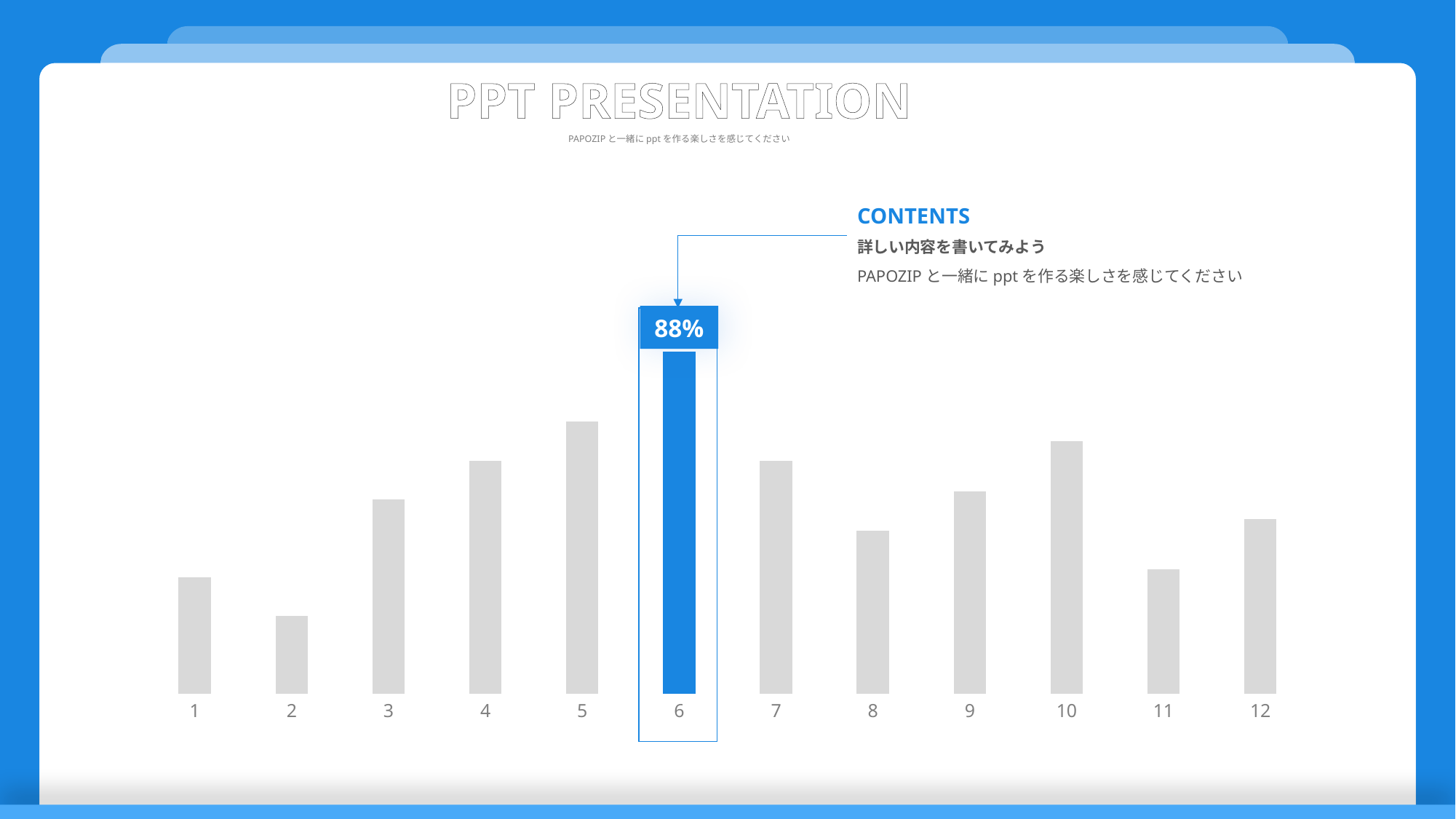
What colour is the highlighted bar for category 6? blue Which bar is taller, category 3 or category 4? 4 Which category has the tallest bar? 6 Which bar is taller, category 1 or category 2? 1 Which category's bar is highlighted with a data label and callout box? 6 Do the bar values rise or fall from category 6 to category 8? fall How many categories are shown on the x axis? 12 Which bar is taller, category 5 or category 7? 5 What value is labelled on the bar for category 6? 88% Which category has the shortest bar? 2 What kind of chart is shown on the slide? bar chart